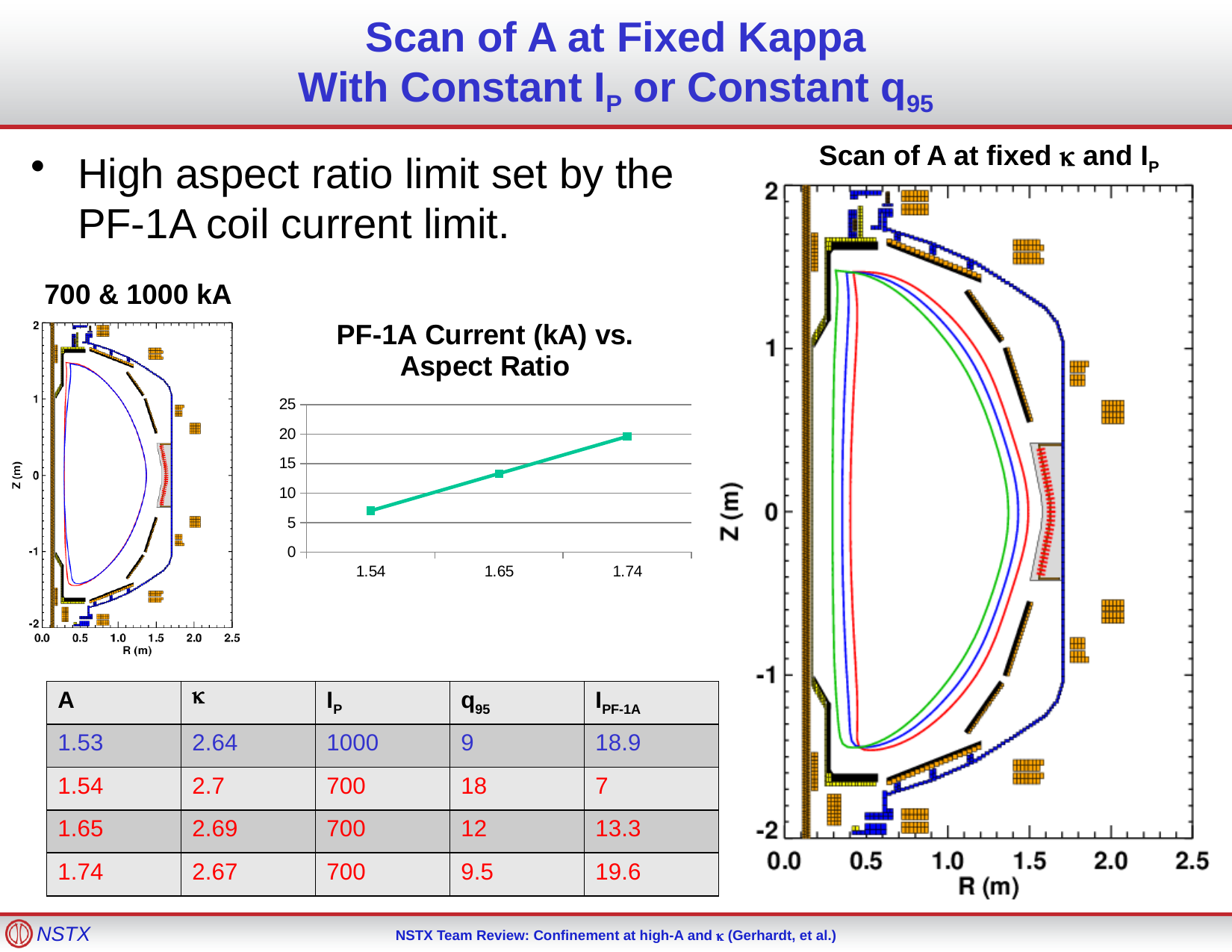
What kind of chart is 'PF-1A Current (kA) vs. Aspect Ratio'? line chart What is the highest tick value shown on the y axis of the 'PF-1A Current (kA) vs. Aspect Ratio' chart? 25 In the 'PF-1A Current (kA) vs. Aspect Ratio' chart, is the value for aspect ratio 1.54 greater or less than 5? greater In the 'PF-1A Current (kA) vs. Aspect Ratio' chart, which aspect ratio has the lowest PF-1A current? 1.54 What is the title of the line chart in the middle of the slide? PF-1A Current (kA) vs. Aspect Ratio In the 'PF-1A Current (kA) vs. Aspect Ratio' chart, which has the larger PF-1A current: aspect ratio 1.65 or 1.54? 1.65 In the 'PF-1A Current (kA) vs. Aspect Ratio' chart, which aspect ratio has the highest PF-1A current? 1.74 In the 'PF-1A Current (kA) vs. Aspect Ratio' chart, do the values rise or fall as aspect ratio increases along the x axis? rise In the 'PF-1A Current (kA) vs. Aspect Ratio' chart, is the value for aspect ratio 1.74 greater or less than 15? greater In the 'PF-1A Current (kA) vs. Aspect Ratio' chart, is the value for aspect ratio 1.54 greater or less than 10? less How many data points are plotted in the 'PF-1A Current (kA) vs. Aspect Ratio' chart? 3